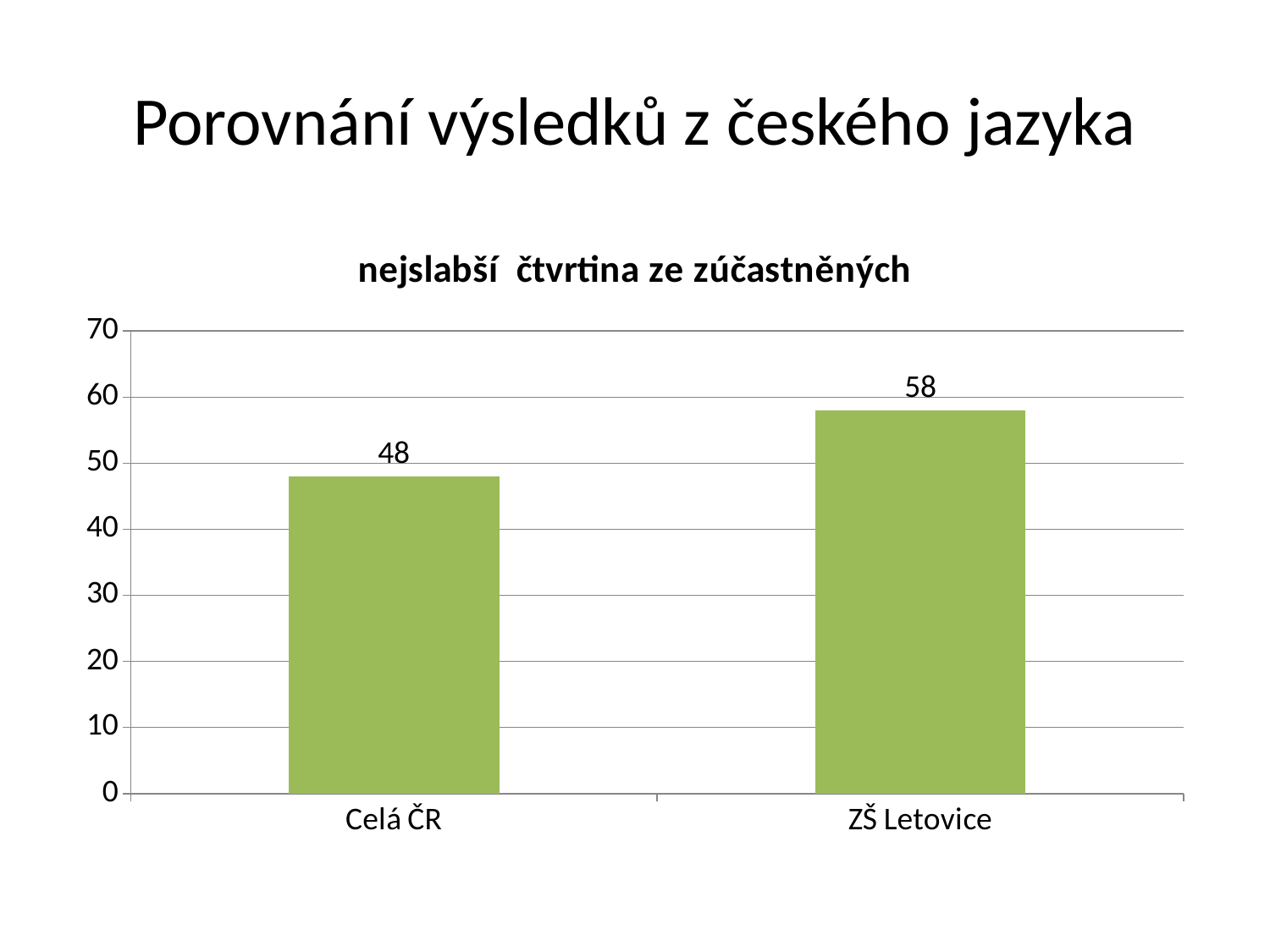
Which category has the highest value? ZŠ Letovice Which is larger, the value for Celá ČR or the value for ZŠ Letovice? ZŠ Letovice What kind of chart is shown on the slide? bar chart What is the maximum value shown on the y axis? 70 Is the value for ZŠ Letovice greater or less than 60? less How many categories are shown on the x axis? 2 What is the difference between the values for ZŠ Letovice and Celá ČR? 10 What is the value for Celá ČR? 48 Is the value for Celá ČR greater or less than 50? less Which category has the lowest value? Celá ČR What is the value for ZŠ Letovice? 58 What is the title of the chart? nejslabší čtvrtina ze zúčastněných